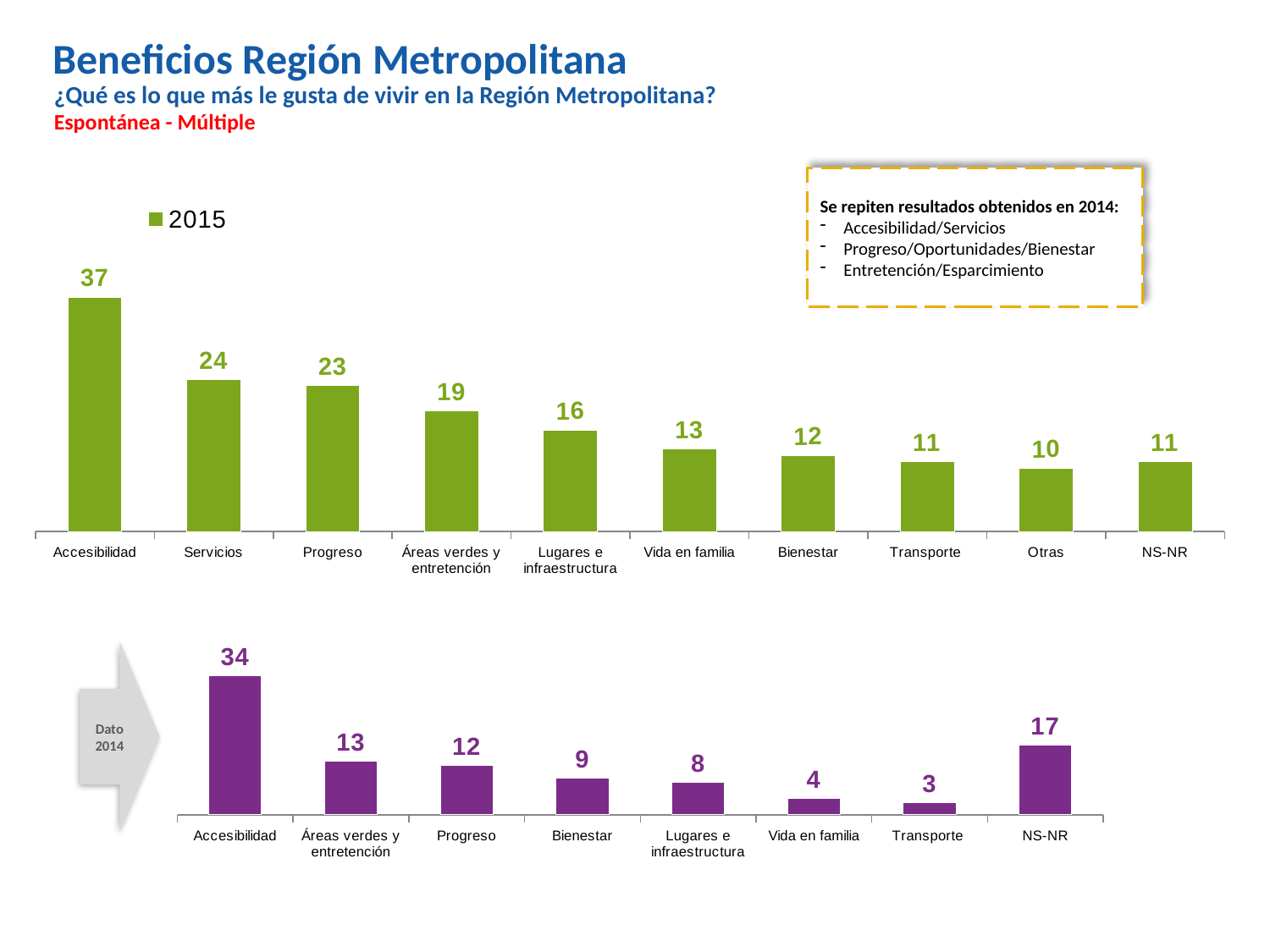
In the bottom (Dato 2014) chart, which category has the lowest value? Transporte In the top (2015) chart, what is the value for Accesibilidad? 37 What type of chart is the top chart? Bar chart In the bottom (Dato 2014) chart, what is the difference between Accesibilidad and Áreas verdes y entretención? 21 In the bottom (Dato 2014) chart, which is larger, Bienestar or Lugares e infraestructura? Bienestar In the top (2015) chart, how many categories are shown? 10 In the top (2015) chart, what is the value for Áreas verdes y entretención? 19 In the top (2015) chart, which category has the lowest value? Otras In the top (2015) chart, which category has the highest value? Accesibilidad In the top (2015) chart, what is the difference between Servicios and Progreso? 1 In the bottom (Dato 2014) chart, what is the value for NS-NR? 17 In the bottom (Dato 2014) chart, how many categories are shown? 8